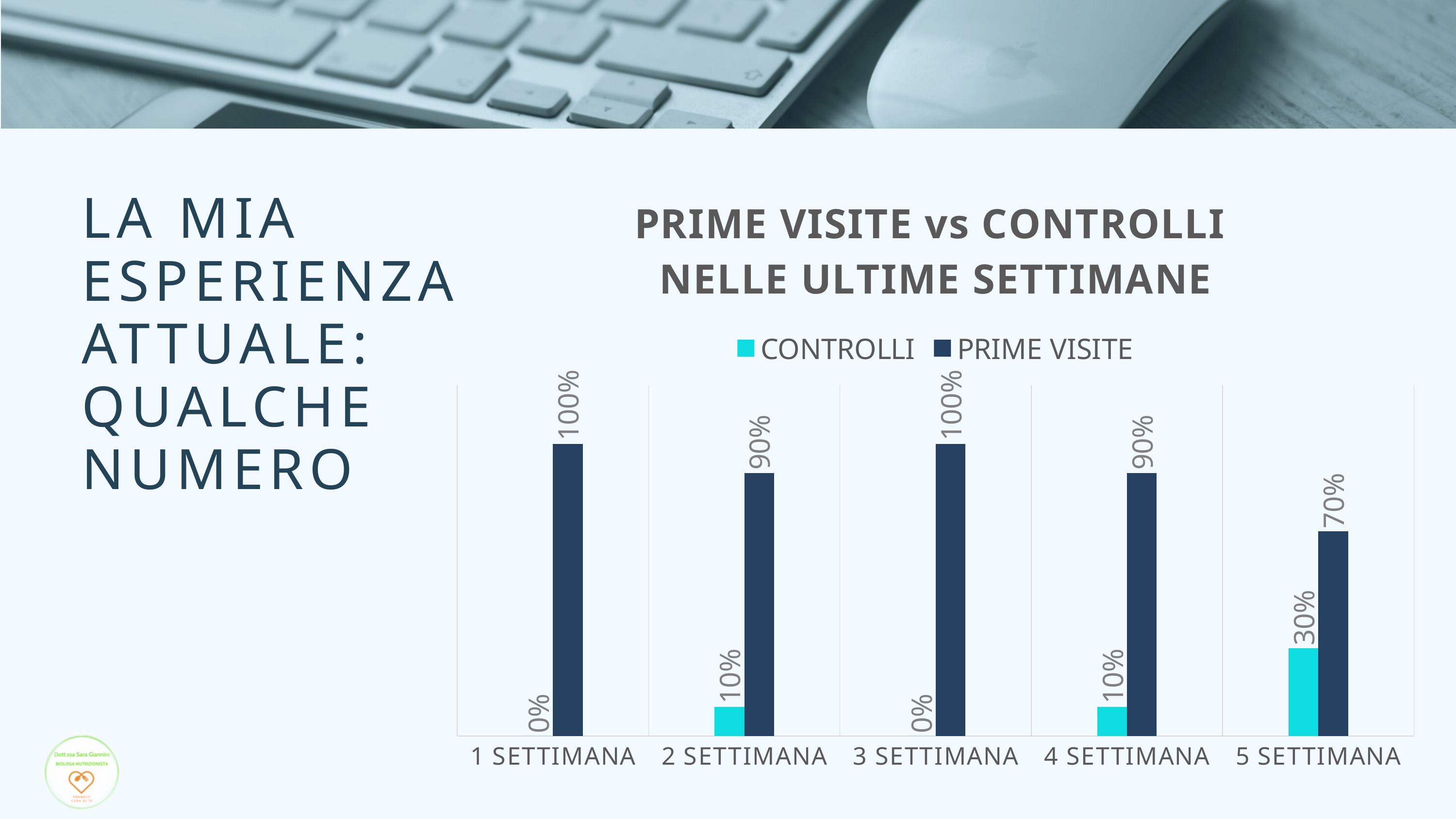
In which week is the PRIME VISITE value lowest? 5 SETTIMANA What is the value for CONTROLLI in 5 SETTIMANA? 30% Which is larger in 4 SETTIMANA, PRIME VISITE or CONTROLLI? PRIME VISITE In which week is the CONTROLLI value highest? 5 SETTIMANA How many series does the legend list? 2 What is the value for PRIME VISITE in 1 SETTIMANA? 100% What kind of chart is shown on the slide? Bar chart What is the value for CONTROLLI in 2 SETTIMANA? 10% What is the difference between PRIME VISITE and CONTROLLI in 5 SETTIMANA? 40% How many weeks (categories) are shown on the x axis? 5 What is the value for PRIME VISITE in 5 SETTIMANA? 70% What is the title of the chart? PRIME VISITE vs CONTROLLI NELLE ULTIME SETTIMANE